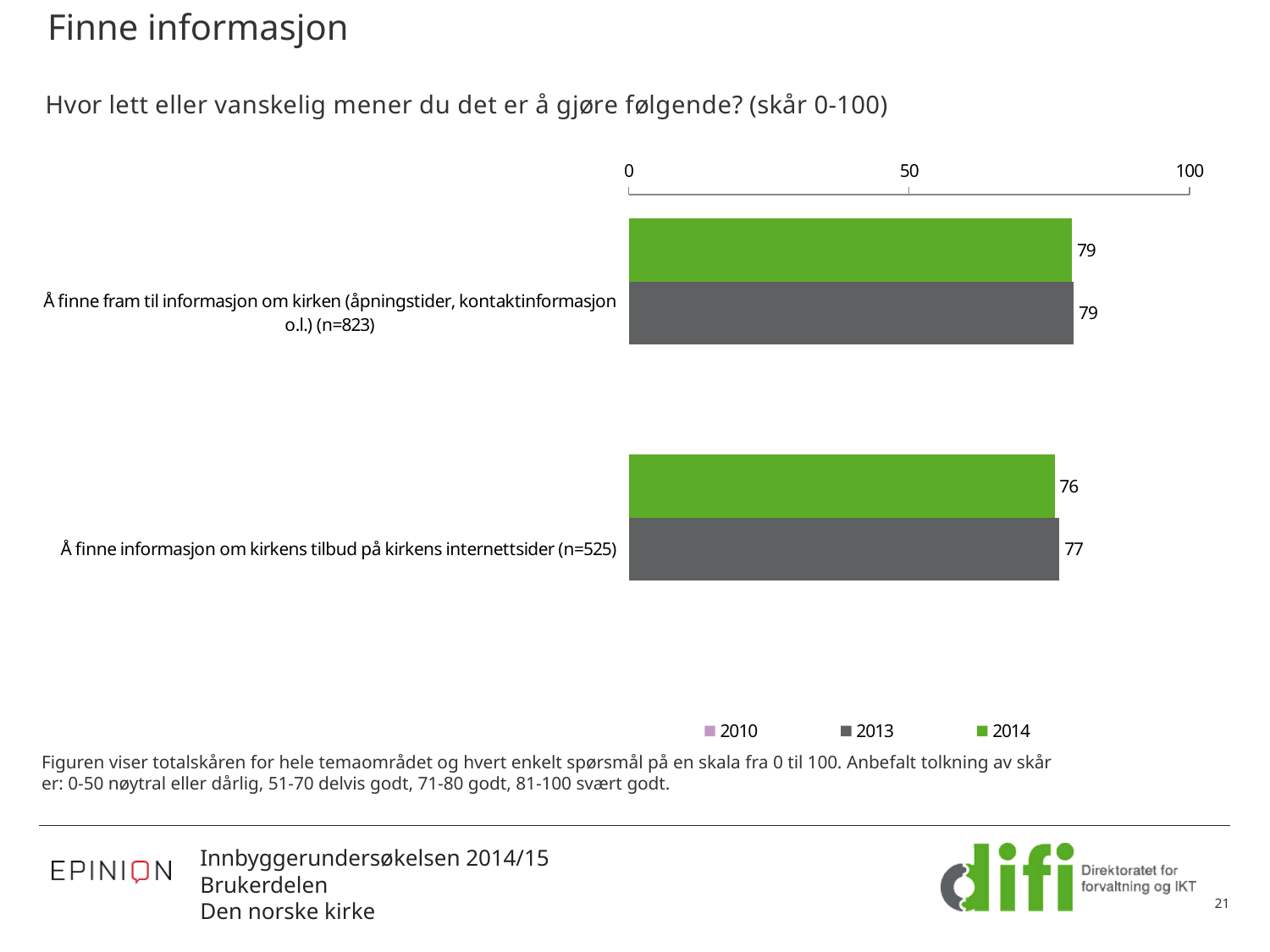
How many series does the legend list? 3 What kind of chart is shown on the slide? bar chart What is the 2013 value for "Å finne informasjon om kirkens tilbud på kirkens internettsider (n=525)"? 77 Is the 2014 value for "Å finne informasjon om kirkens tilbud på kirkens internettsider (n=525)" greater or less than 50? greater What is the 2014 value for "Å finne informasjon om kirkens tilbud på kirkens internettsider (n=525)"? 76 Which category has the higher 2014 value? Å finne fram til informasjon om kirken (åpningstider, kontaktinformasjon o.l.) (n=823) What is the 2014 value for "Å finne fram til informasjon om kirken (åpningstider, kontaktinformasjon o.l.) (n=823)"? 79 What is the 2013 value for "Å finne fram til informasjon om kirken (åpningstider, kontaktinformasjon o.l.) (n=823)"? 79 Which category has the lowest 2013 value? Å finne informasjon om kirkens tilbud på kirkens internettsider (n=525) What is the difference between the 2013 and 2014 values for "Å finne informasjon om kirkens tilbud på kirkens internettsider (n=525)"? 1 How many categories are shown in the chart? 2 What is the difference between the 2014 values of the two categories? 3